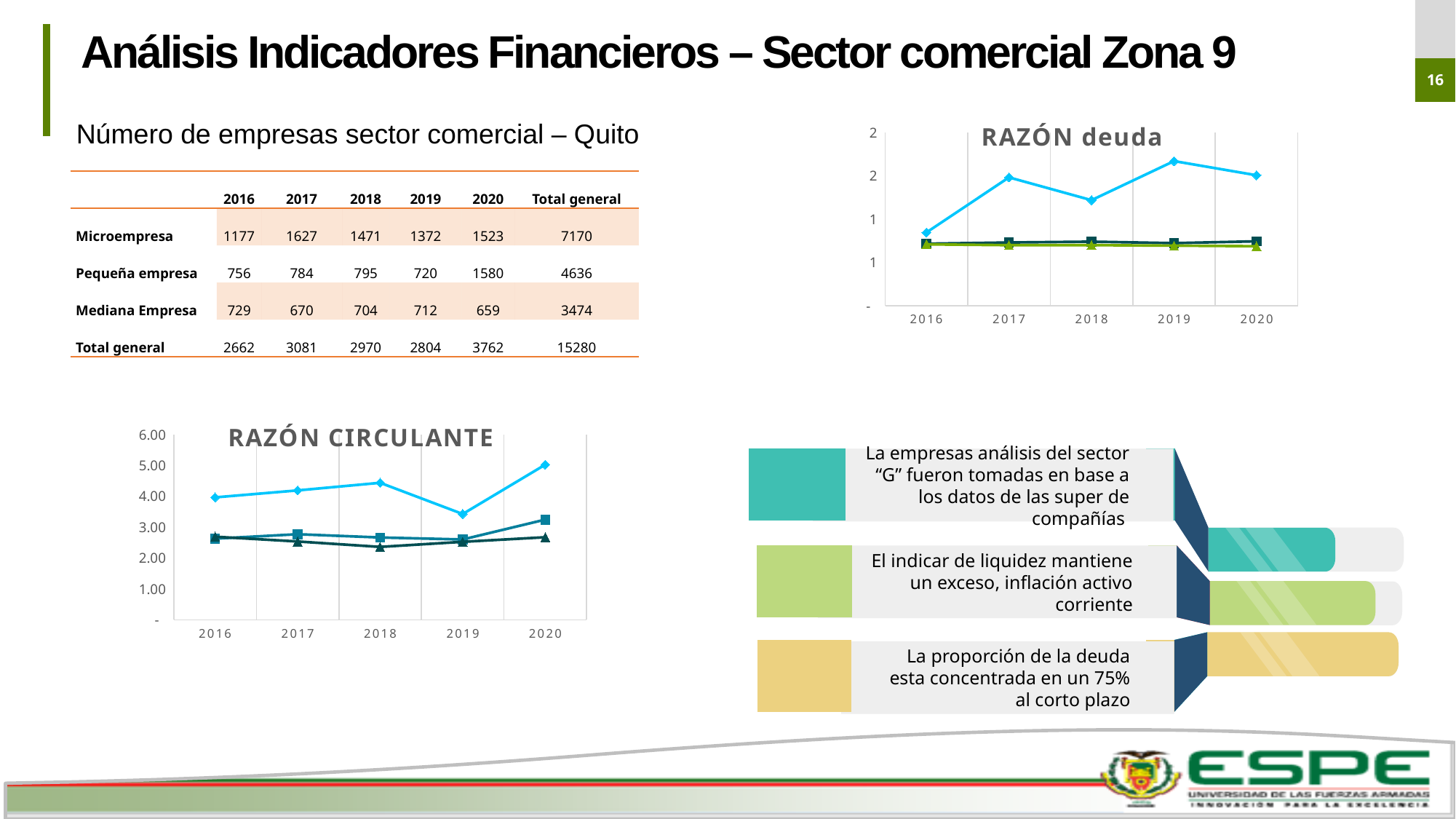
In the RAZÓN CIRCULANTE chart, is the lowest value plotted for 2016 greater or less than 2.00? greater What kind of chart is the RAZÓN CIRCULANTE chart? Line chart In the RAZÓN CIRCULANTE chart, which year has the highest plotted value? 2020 How many years are shown on the x axis of the RAZÓN CIRCULANTE chart? 5 In the RAZÓN deuda chart, which year has the highest plotted value? 2019 How many lines are plotted in the RAZÓN CIRCULANTE chart? 3 In the RAZÓN CIRCULANTE chart, is the highest value plotted for 2020 greater or less than 4.00? greater In the RAZÓN CIRCULANTE chart, does the top line rise or fall from 2019 to 2020? Rises What kind of chart is the RAZÓN deuda chart? Line chart In the RAZÓN CIRCULANTE chart, is the highest value plotted for 2019 greater or less than 4.00? less What is the title of the line chart in the top right of the slide? RAZÓN deuda How many years are shown on the x axis of the RAZÓN deuda chart? 5